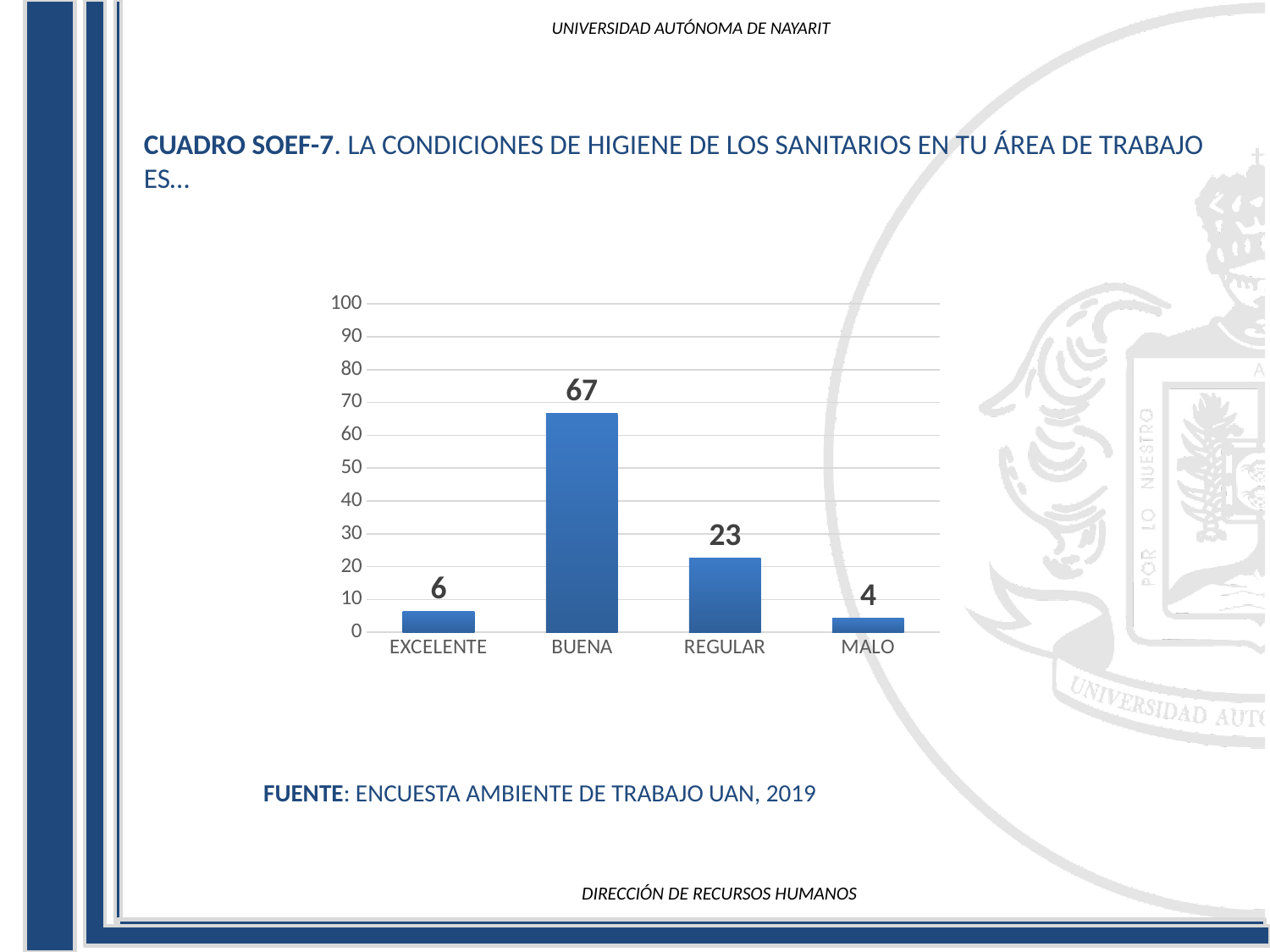
Is the value for BUENA greater or less than 60? greater How many categories are shown on the x axis? 4 What is the value for BUENA? 67 Which category has the lowest value? MALO Which is larger, the value for REGULAR or the value for EXCELENTE? REGULAR What is the value for REGULAR? 23 What is the value for MALO? 4 Which category has the highest value? BUENA What is the difference between the values for EXCELENTE and MALO? 2 What is the value for EXCELENTE? 6 What kind of chart is shown on the slide? bar chart What is the difference between the values for BUENA and REGULAR? 44